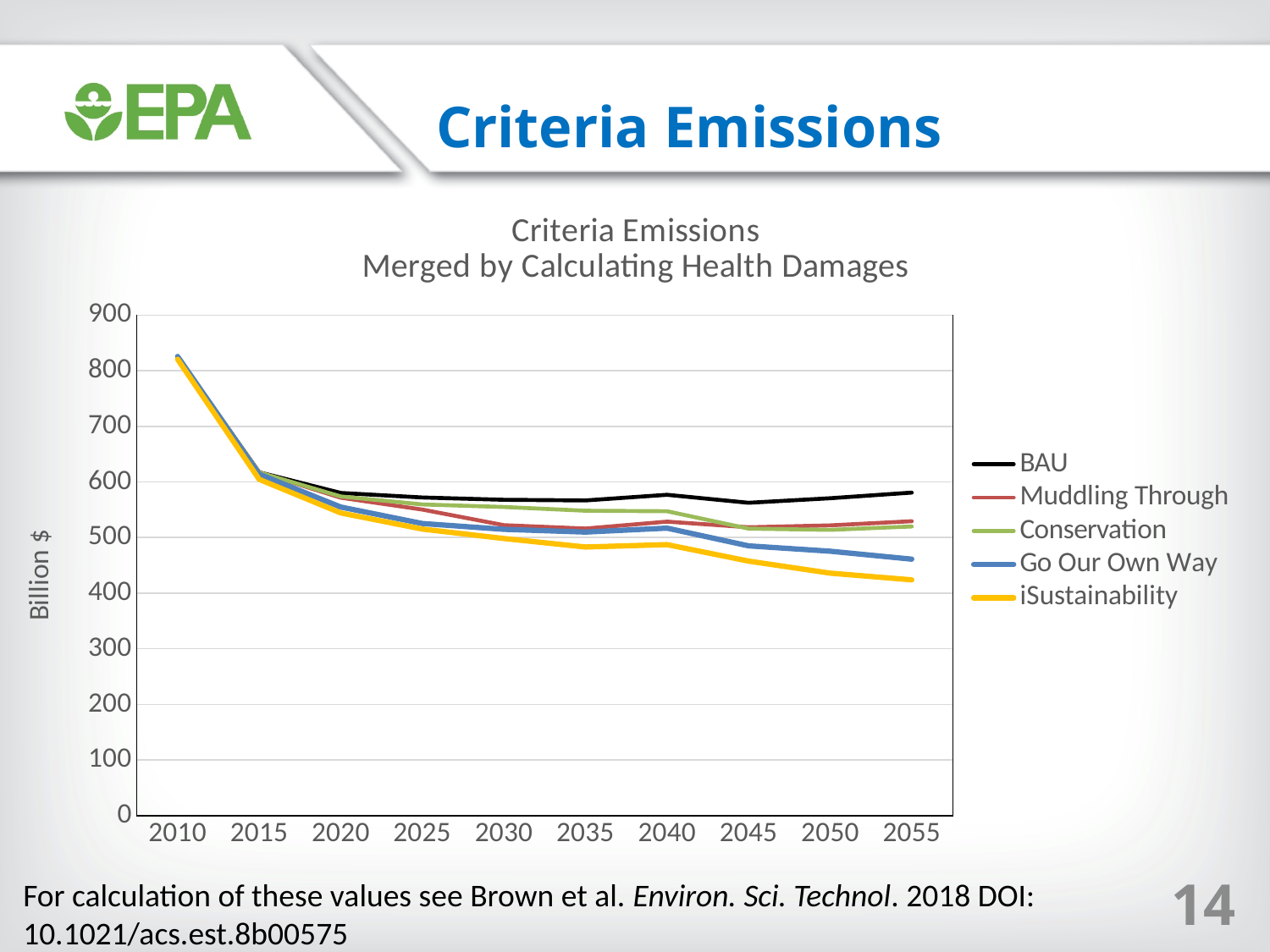
In 2045, which is larger: Conservation or Go Our Own Way? Conservation Is the value for Go Our Own Way in 2055 greater or less than 400? greater What kind of chart is shown on the slide? line chart Which series has the highest value in 2055? BAU What is the label on the y axis? Billion $ How many years are plotted along the x axis? 10 What is the title of the chart? Criteria Emissions Merged by Calculating Health Damages Which series has the lowest value in 2055? iSustainability Is the value for iSustainability in 2055 greater or less than 500? less Do the iSustainability values rise or fall from 2010 to 2055? fall How many series does the legend list? 5 Is the value for BAU in 2055 greater or less than 500? greater